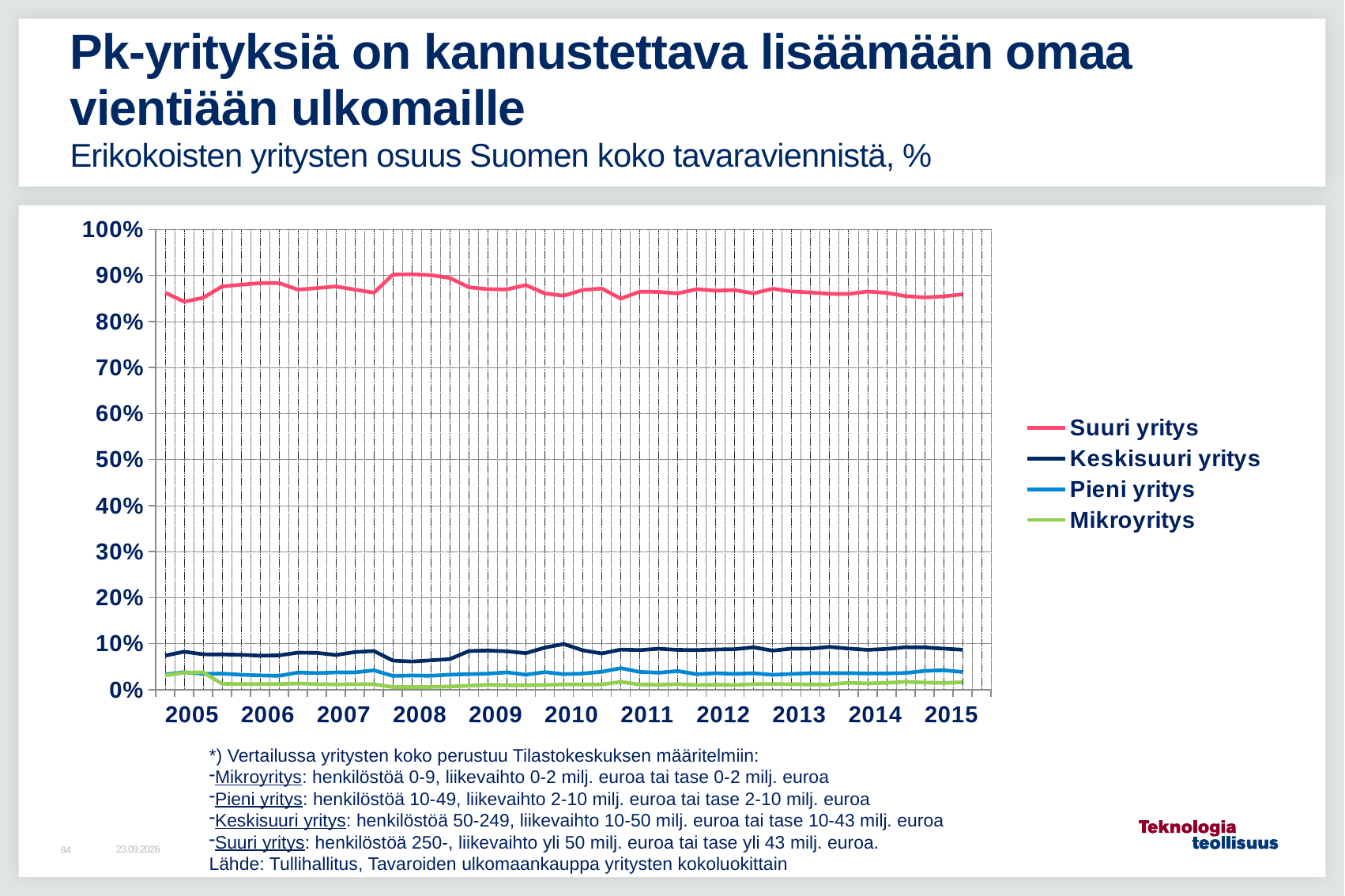
What kind of chart is shown on the slide? line chart Which series has the highest values throughout the chart? Suuri yritys How many series does the legend list? 4 Which series is larger in 2013, Pieni yritys or Mikroyritys? Pieni yritys What colour is the line for Mikroyritys in the legend? green What is the first year shown on the x axis? 2005 Is the value for Keskisuuri yritys in 2012 greater or less than 20%? less Is the value for Pieni yritys in 2008 greater or less than 10%? less Which series is larger in 2014, Keskisuuri yritys or Pieni yritys? Keskisuuri yritys Is the value for Suuri yritys in 2010 greater or less than 80%? greater